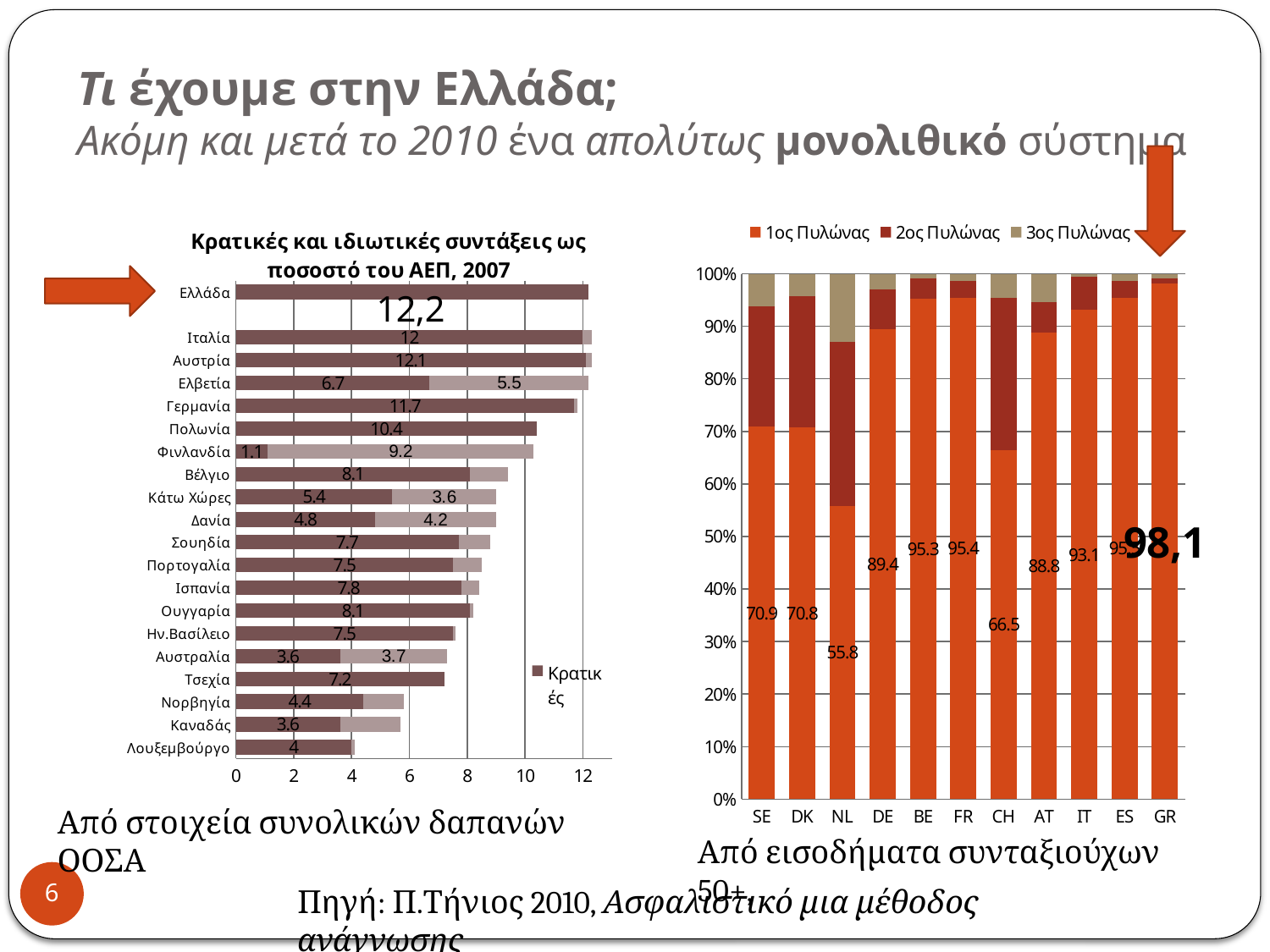
In the right chart, what is the value of 1ος Πυλώνας for NL? 55.8 In the right chart, which country has the highest 1ος Πυλώνας share? GR How many countries are shown on the x axis of the right chart? 11 In the right chart, which has the larger 1ος Πυλώνας value, CH or AT? AT In the left chart, what is the value of the Κρατικές segment for Ελβετία? 6.7 In the right chart, which country has the lowest 1ος Πυλώνας share? NL What kind of chart is the left chart titled 'Κρατικές και ιδιωτικές συντάξεις ως ποσοστό του ΑΕΠ, 2007'? Bar chart In the right chart, what is the value of 1ος Πυλώνας for GR? 98,1 How many series does the legend of the right chart list? 3 In the left chart, what is the total of the two segments for Δανία? 9 In the right chart, what is the difference between the 1ος Πυλώνας values for DE and AT? 0.6 How many countries are listed in the left chart? 20